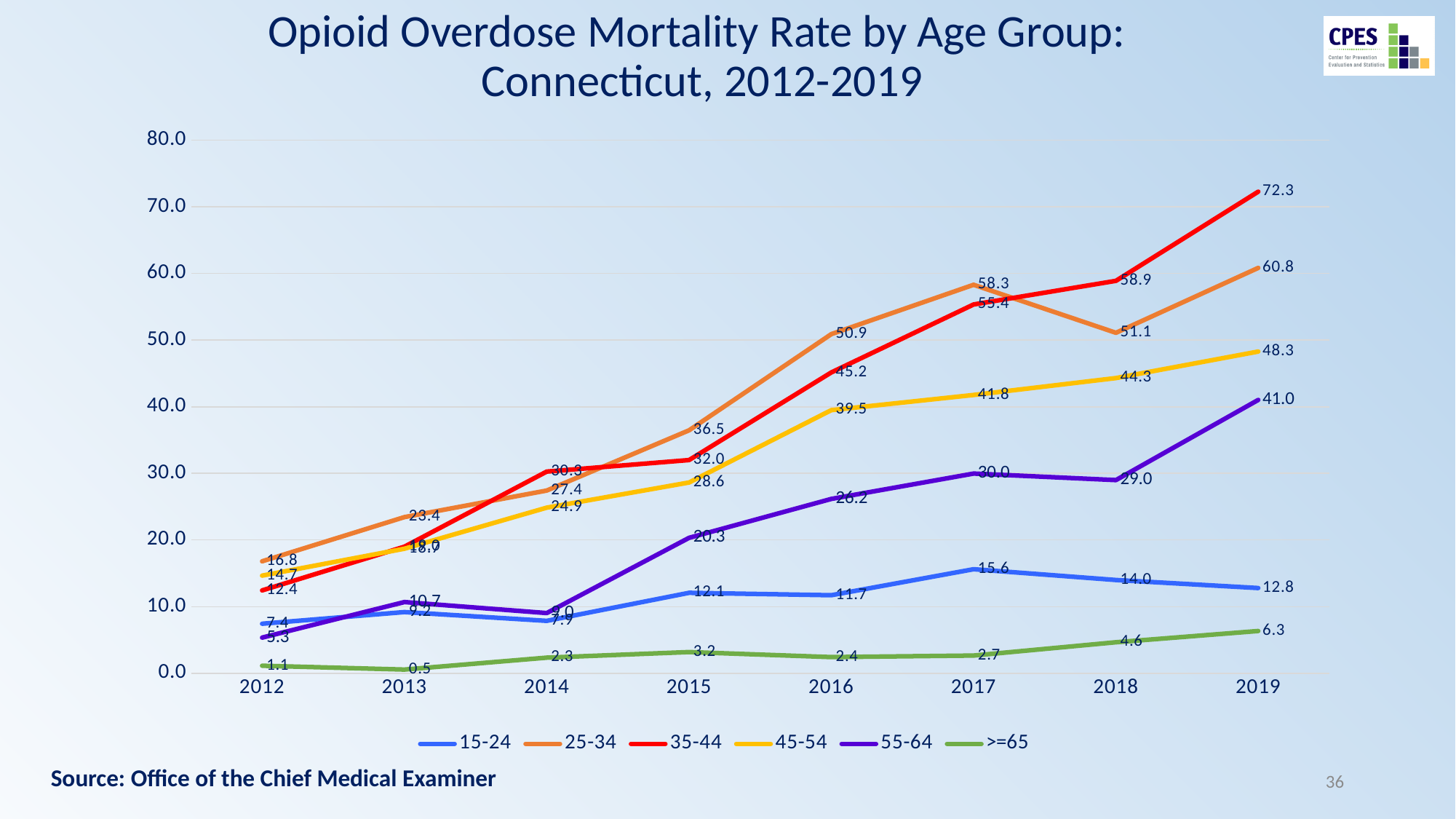
What is the difference between the 35-44 and 25-34 values in 2019? 11.5 What is the opioid overdose mortality rate for the 35-44 age group in 2019? 72.3 What is the value for the >=65 age group in 2013? 0.5 Which age group has the lowest mortality rate in 2019? >=65 Does the value for the 45-54 age group rise or fall from 2012 to 2019? rise How many age groups does the legend list? 6 What is the value for the 25-34 age group in 2017? 58.3 Is the value for the 55-64 age group in 2019 greater or less than 40? greater Which age group has the highest mortality rate in 2019? 35-44 How many years are shown on the x axis? 8 In 2018, which is larger: the value for 25-34 or the value for 45-54? 25-34 What kind of chart is shown on the slide? line chart